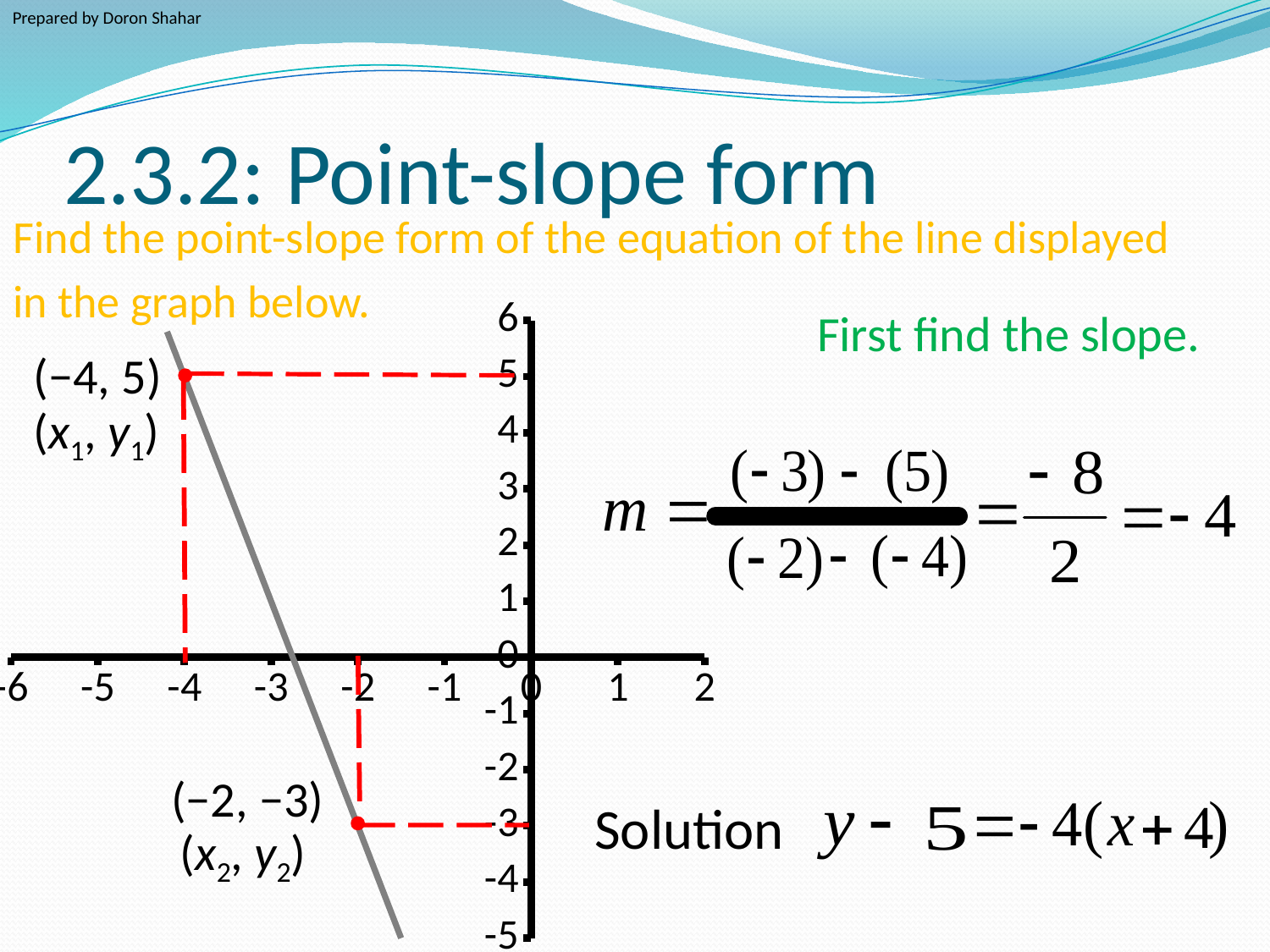
Is the y-value of the marked point at x = −4 greater or less than 4? greater How many points are marked with red dots on the line? 2 Does the plotted line rise or fall as x increases? falls Is the y-value of the marked point at x = −2 greater or less than −2? less What is the lowest value labeled on the x-axis of the graph? -6 What slope m is computed for the line on the slide? −4 What is the highest value labeled on the y-axis of the graph? 6 Which of the two marked points has the larger y-value, (−4, 5) or (−2, −3)? (−4, 5) What are the coordinates of the point labeled (x1, y1) on the graph? (−4, 5) What are the coordinates of the point labeled (x2, y2) on the graph? (−2, −3) What is the difference between the y-values of the two marked points, 5 and −3? 8 What is the difference between the x-values of the two marked points, −2 and −4? 2